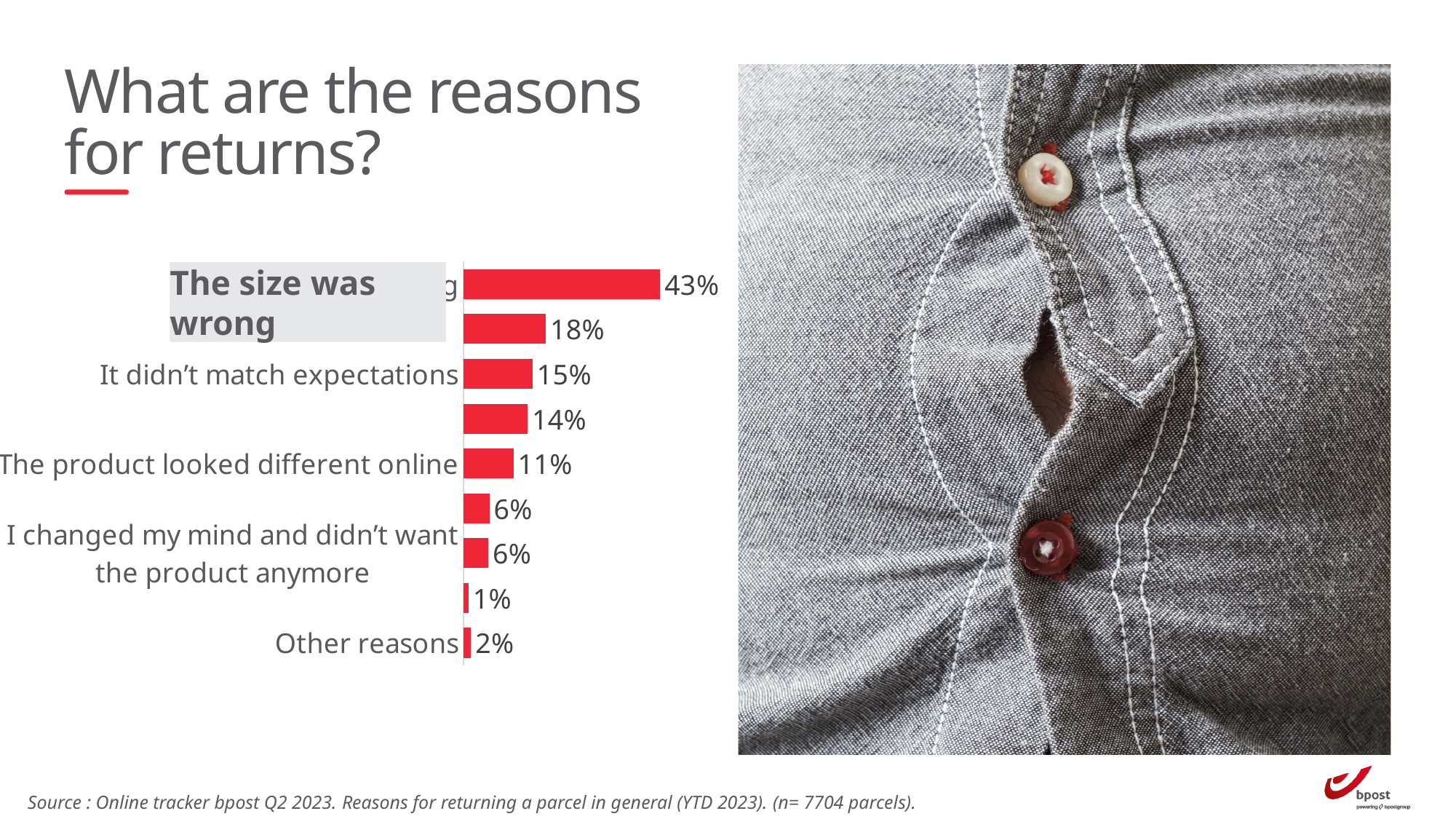
What colour are the bars in the chart? Red Which is larger: "It didn't match expectations" or "Other reasons"? It didn't match expectations What is the highest value shown in the chart? 43% What percentage is shown for "The size was wrong"? 43% What percentage is shown for "I changed my mind and didn't want the product anymore"? 6% What percentage is shown for "The product looked different online"? 11% What is the lowest value shown in the chart? 1% What percentage is shown for "It didn't match expectations"? 15% What kind of chart is shown on the slide? Bar chart How many bars are plotted in the chart? 9 What percentage is shown for "Other reasons"? 2% What is the difference between "It didn't match expectations" and "The product looked different online"? 4 percentage points